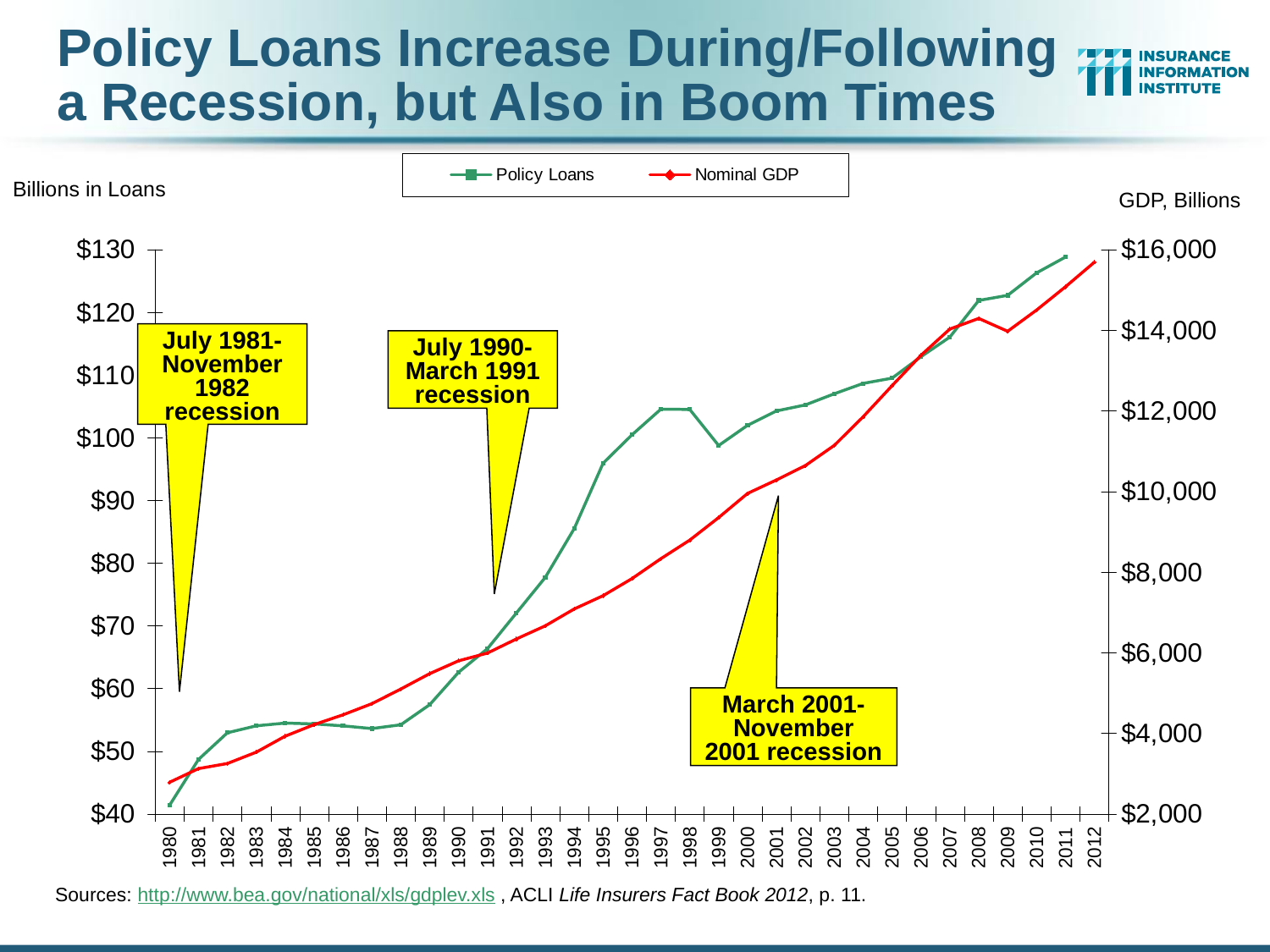
In which year is the Policy Loans series at its highest? 2011 Is the Policy Loans value for 2011 greater or less than $120? greater What kind of chart is shown on the slide? Line chart Is the Policy Loans value for 1980 greater or less than $50? less How many years are shown on the x axis, from 1980 to 2012? 33 Overall, does the Nominal GDP line rise or fall from 1980 to 2012? Rise Is the Policy Loans value for 1997 greater or less than $100? greater How many series does the legend list? 2 In which year is the Policy Loans series at its lowest? 1980 Which two series are listed in the legend? Policy Loans and Nominal GDP